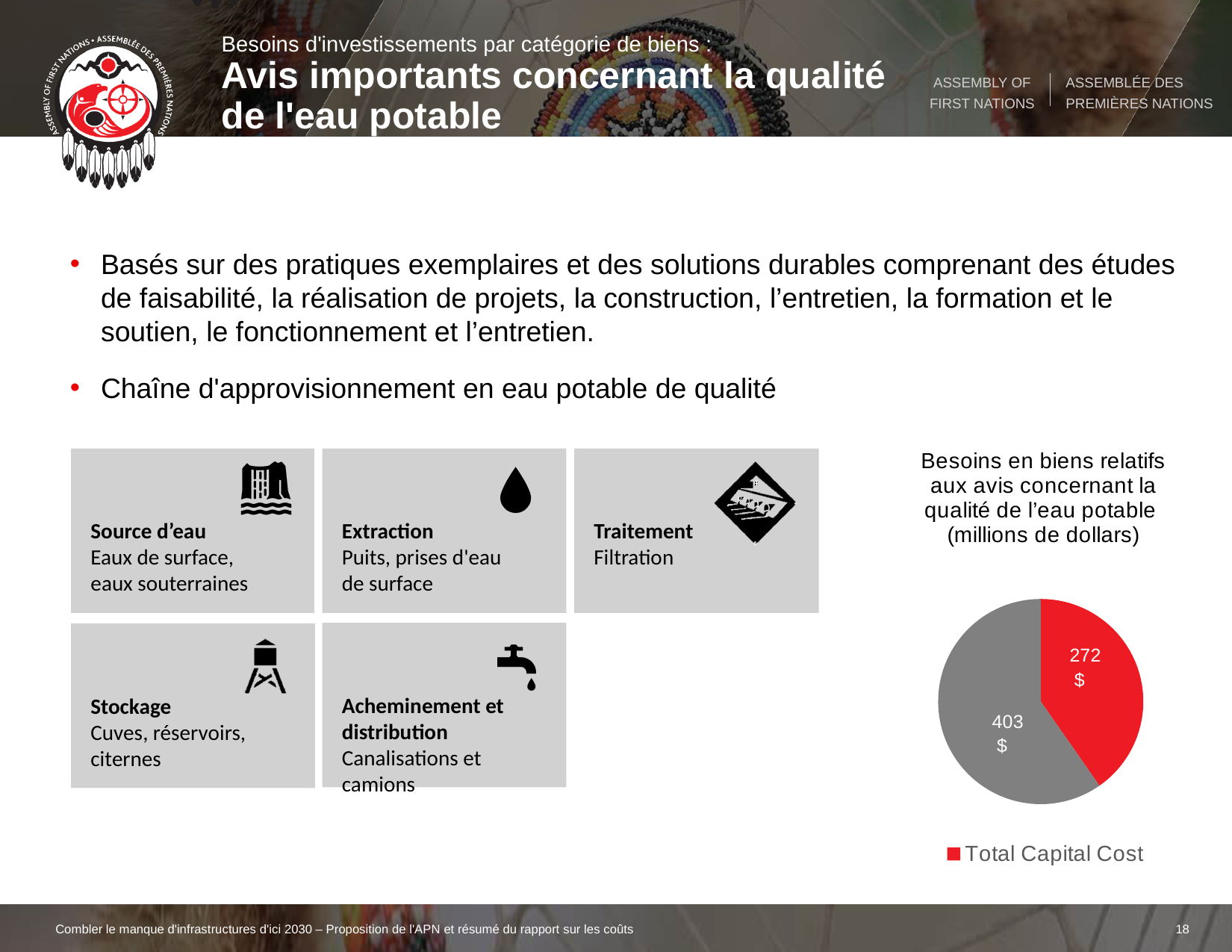
What is the value of the grey slice in the pie chart? 403 $ What share of the pie does the red slice (272 $) represent, to the nearest percent? 40% Which slice of the pie chart has the larger value, the red one or the grey one? the grey one What is the smallest value shown in the pie chart? 272 $ What is the difference between the grey slice and the red slice in the pie chart? 131 $ What is the largest value shown in the pie chart? 403 $ How many slices does the pie chart have? 2 What is the value of the red slice (Total Capital Cost) in the pie chart? 272 $ What is the total of the two values shown in the pie chart? 675 $ How many entries does the legend of the pie chart list? 1 What kind of chart is shown on the slide? pie chart What unit does the chart title say the values are in? millions de dollars